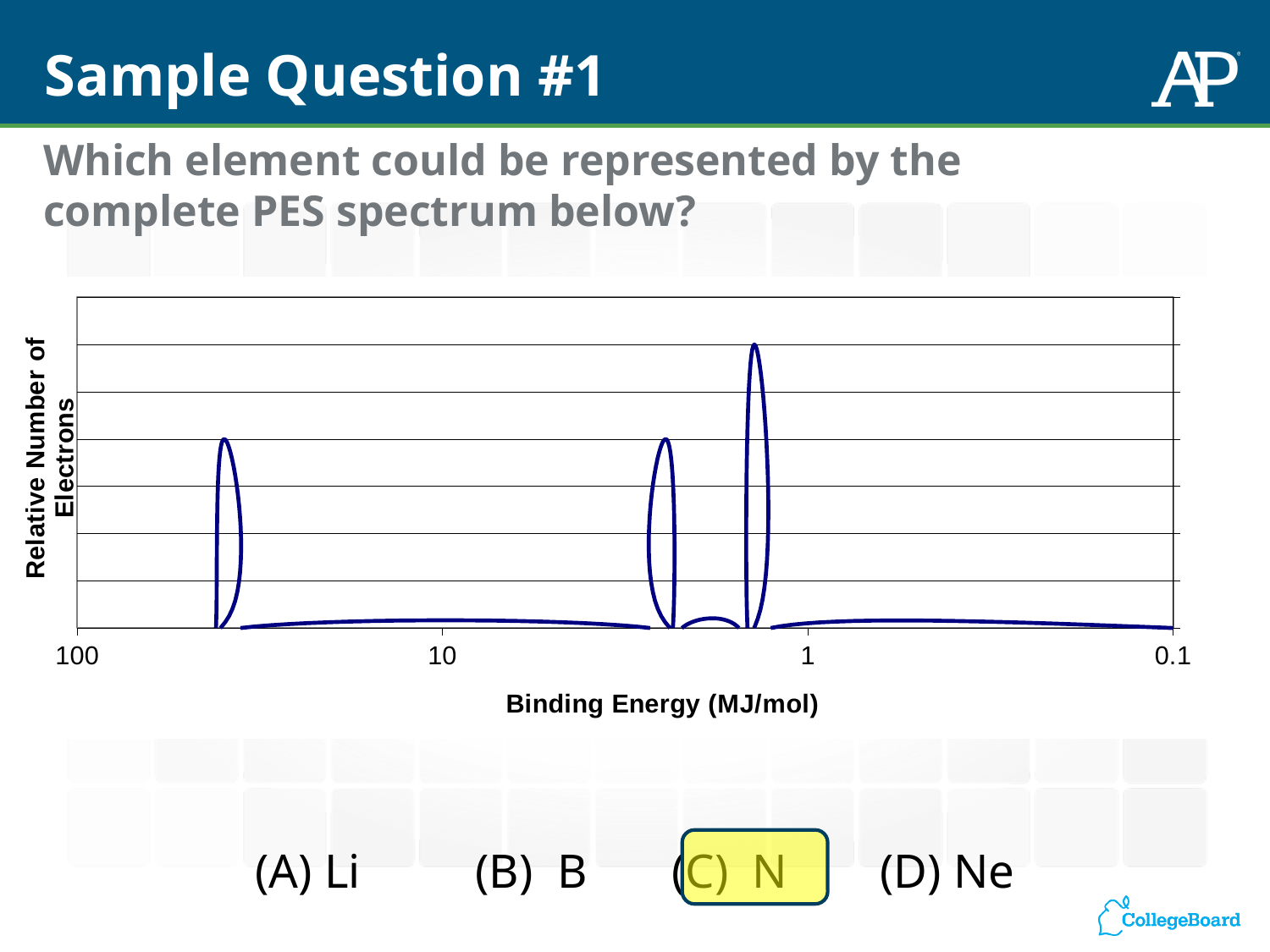
Is the binding energy of the leftmost peak greater or less than 10 MJ/mol? greater What value is shown at the left end of the x axis? 100 What is the title of the y axis? Relative Number of Electrons What value is shown at the right end of the x axis? 0.1 What kind of chart is shown on the slide? line chart Is the rightmost peak taller or shorter than the leftmost peak? taller Which peak in the spectrum is the tallest: the leftmost, the middle, or the rightmost? rightmost Is the binding energy of the tallest peak greater or less than 10 MJ/mol? less How many peaks does the PES spectrum show? 3 Is the binding energy of the middle peak greater or less than 1 MJ/mol? greater What is the title of the x axis? Binding Energy (MJ/mol)